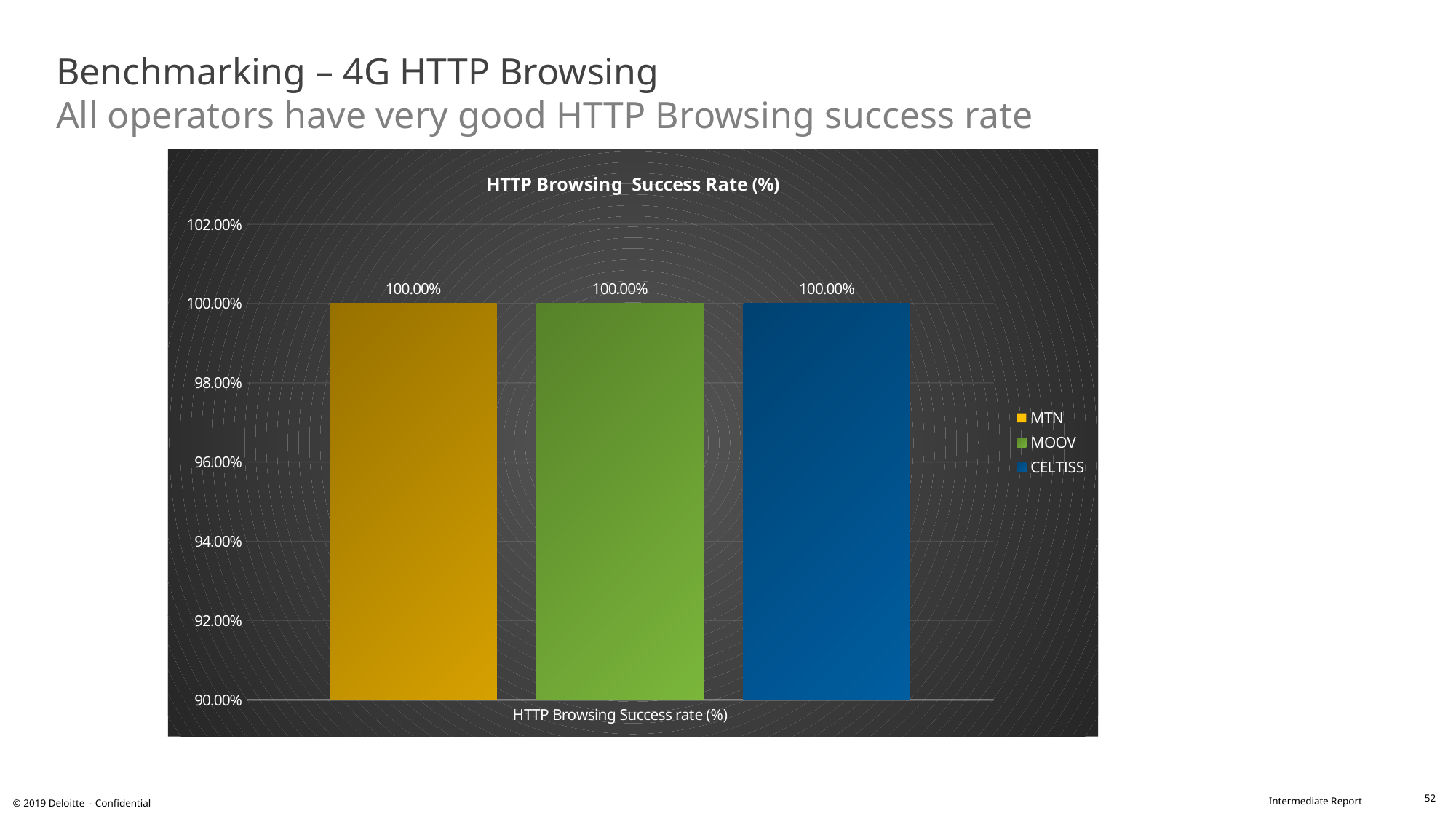
What is the difference between the HTTP Browsing success rates of MTN and CELTISS? 0.00% What is the total of the three operators' HTTP Browsing success rates? 300.00% How many bars are plotted in the chart? 3 Is the value for MOOV greater or less than 98.00%? greater What kind of chart is shown on the slide? Bar chart What is the HTTP Browsing success rate for MTN? 100.00% What is the HTTP Browsing success rate for CELTISS? 100.00% How many series does the legend list? 3 What is the HTTP Browsing success rate for MOOV? 100.00% What is the title of the chart? HTTP Browsing Success Rate (%) Is the value for CELTISS greater or less than 102.00%? less Which operator is represented by the blue bar? CELTISS